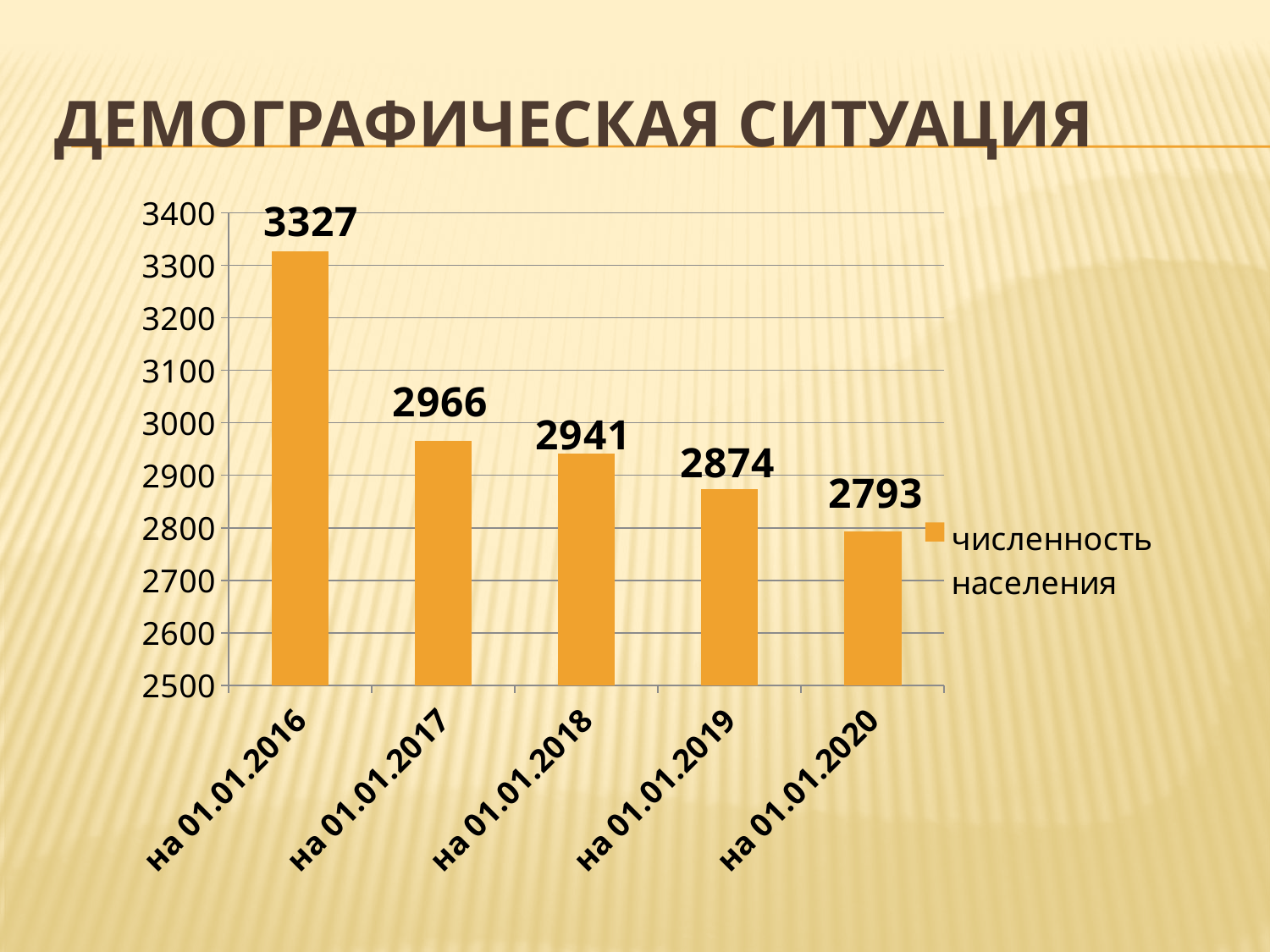
What is the difference between the values for на 01.01.2019 and на 01.01.2020? 81 Which is larger, the value for на 01.01.2017 or на 01.01.2019? на 01.01.2017 Which date has the highest population value? на 01.01.2016 What kind of chart is shown on the slide? bar chart What is the population value for на 01.01.2020? 2793 What is the population value for на 01.01.2018? 2941 Which date has the lowest population value? на 01.01.2020 Is the value for на 01.01.2018 greater or less than 3000? less What is the difference between the values for на 01.01.2016 and на 01.01.2017? 361 Do the values rise or fall from на 01.01.2016 to на 01.01.2020? fall What is the population value for на 01.01.2016? 3327 How many dates are shown on the x axis? 5